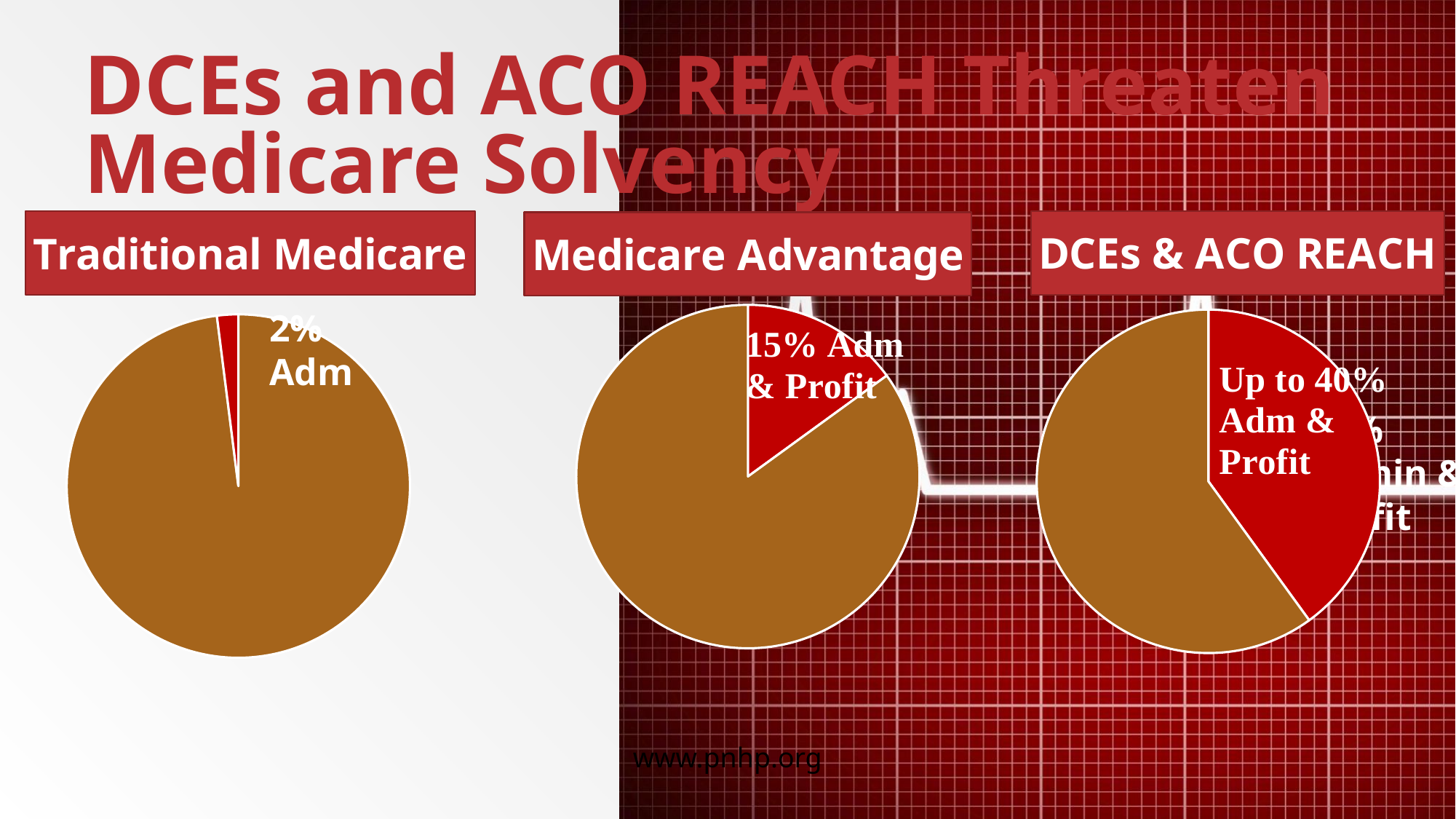
How many slices does the 'Medicare Advantage' pie chart have? 2 In the 'Traditional Medicare' pie chart, what share is labelled as Adm? 2% In the 'Medicare Advantage' pie chart, what share is labelled as Adm & Profit? 15% What kind of chart is used under the 'Traditional Medicare' heading? pie chart What is the difference between the Adm & Profit share in the 'Medicare Advantage' pie chart and the Adm share in the 'Traditional Medicare' pie chart? 13% What colour is used for the Adm & Profit slice in each pie chart? red Which of the three pie charts shows the largest red Adm & Profit slice? DCEs & ACO REACH What is the title of the slide containing the three pie charts? DCEs and ACO REACH Threaten Medicare Solvency Is the Adm & Profit share larger in the 'Medicare Advantage' pie chart or the 'Traditional Medicare' pie chart? Medicare Advantage In the 'DCEs & ACO REACH' pie chart, what share is labelled as Adm & Profit? Up to 40% How many pie charts are shown on the slide? 3 Which of the three pie charts shows the smallest red Adm slice? Traditional Medicare